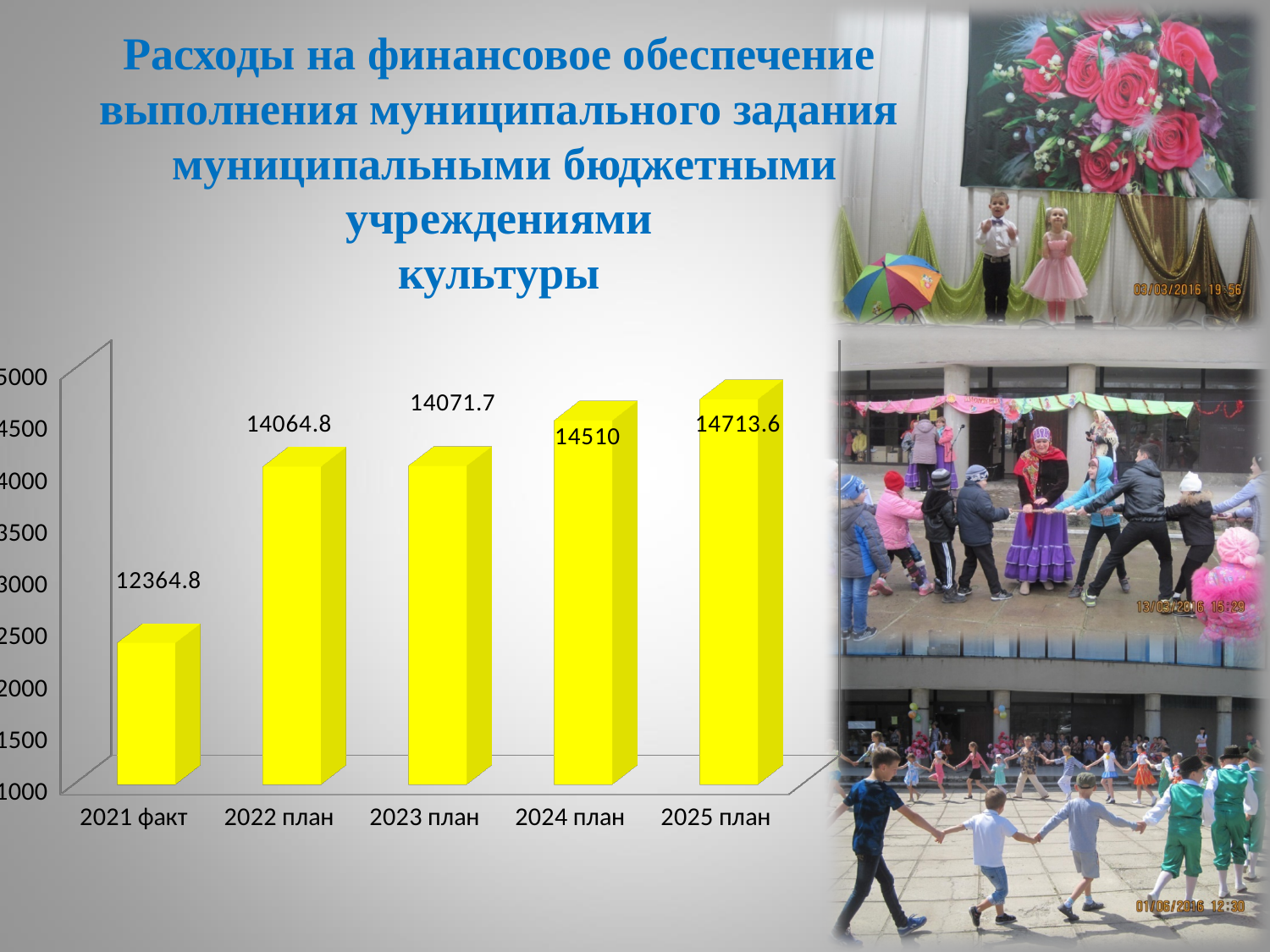
Do the values rise or fall from 2021 факт to 2025 план? Rise Which category has the lowest value? 2021 факт What is the value for 2021 факт? 12364.8 What kind of chart is shown on the slide? Bar chart How many categories are shown on the x axis? 5 What is the value for 2024 план? 14510 Which is larger, the value for 2021 факт or the value for 2024 план? 2024 план What is the difference between the values for 2024 план and 2022 план? 445.2 Which category has the highest value? 2025 план What is the value for 2023 план? 14071.7 What is the value for 2025 план? 14713.6 What is the difference between the values for 2025 план and 2021 факт? 2348.8